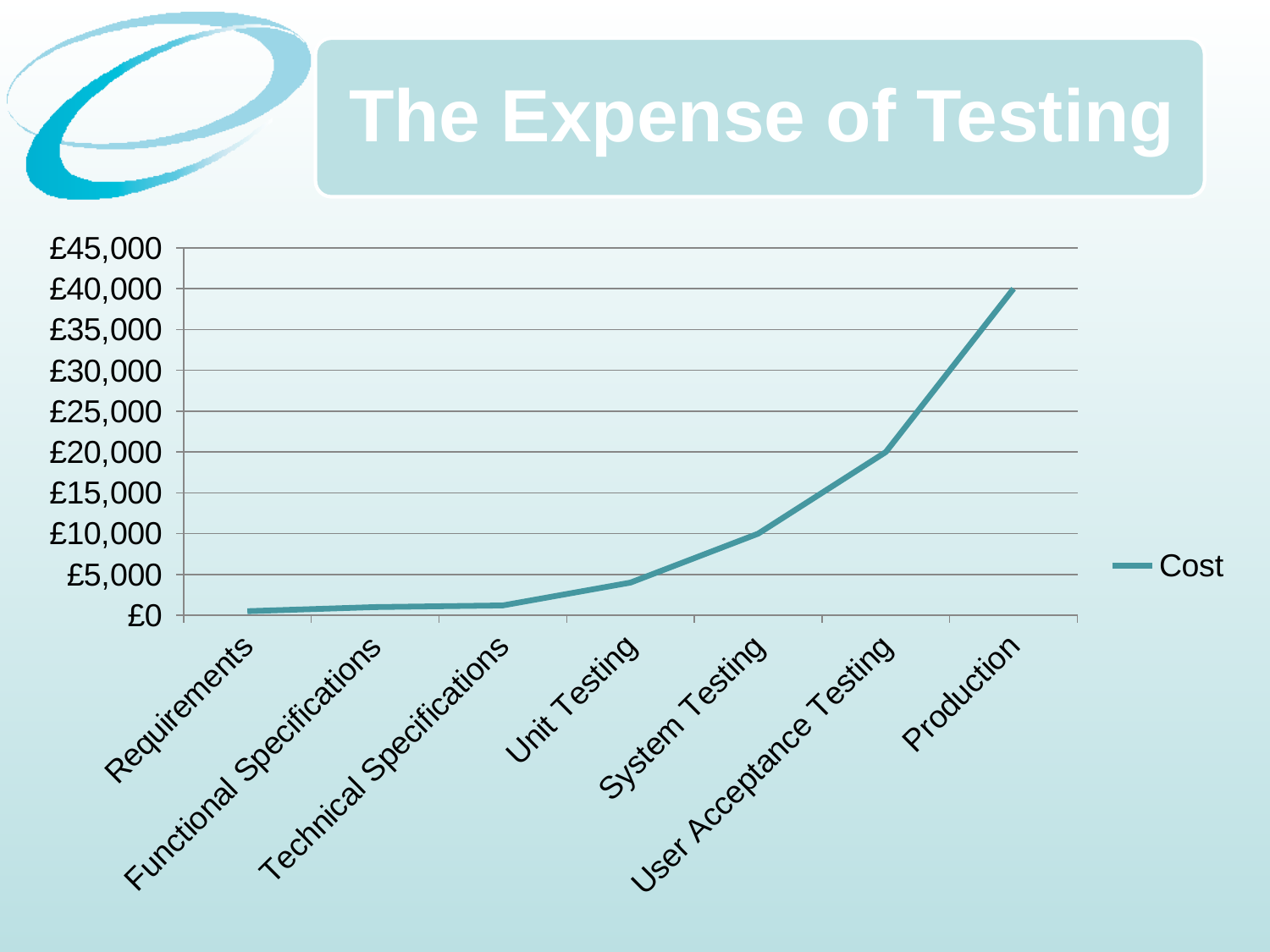
Is the cost for Unit Testing greater or less than £10,000? less What is the name of the series shown in the legend? Cost Does the cost rise or fall from Requirements to Production? rise Which stage has the highest cost? Production Which stage has the lowest cost? Requirements How many stages are plotted along the x axis? 7 What is the cost at the Production stage? £40,000 What kind of chart is shown on the slide? line chart Is the cost for System Testing greater or less than £15,000? less Which has the larger cost, System Testing or Unit Testing? System Testing What is the cost at the User Acceptance Testing stage? £20,000 How many series does the legend list? 1